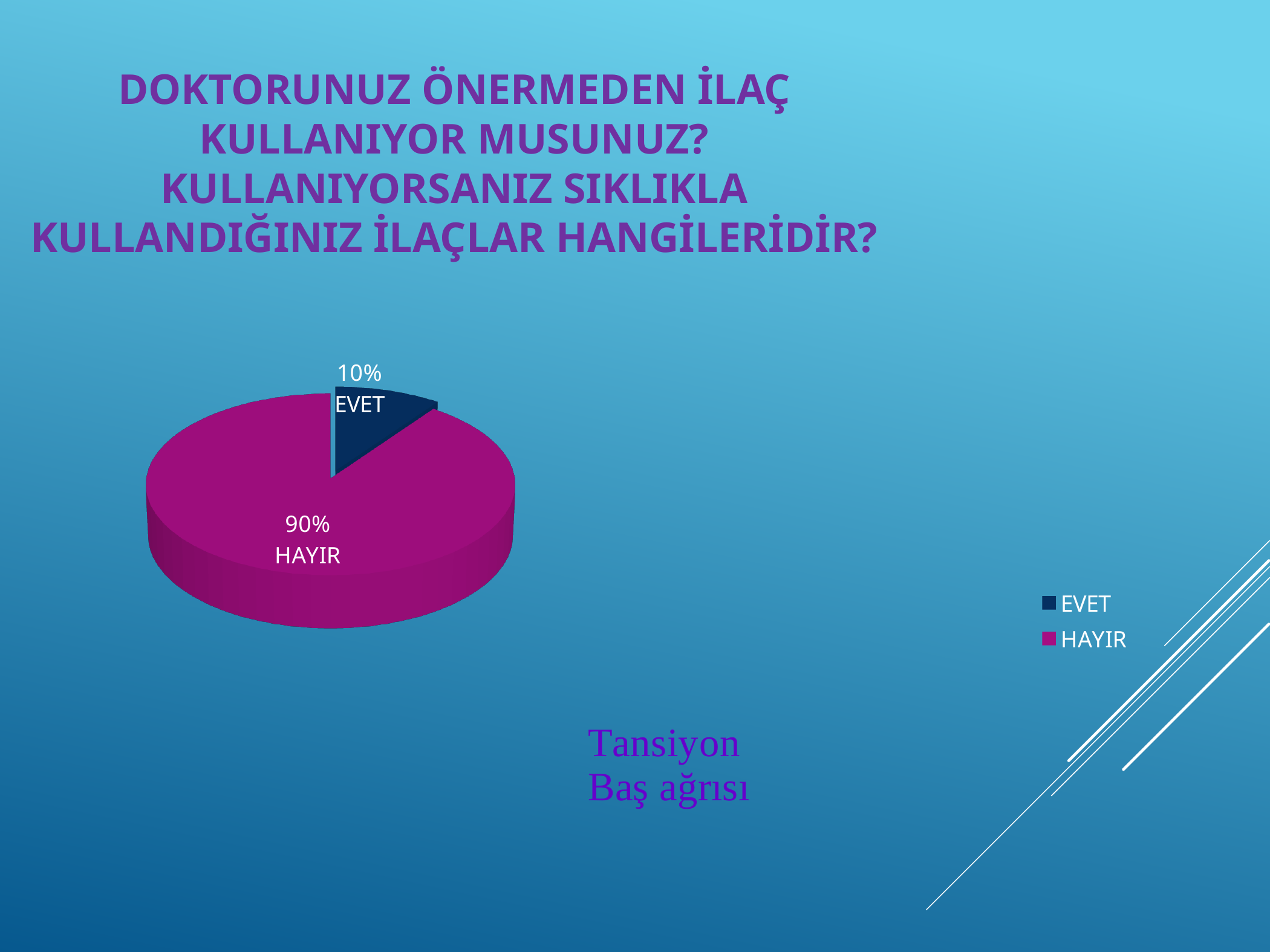
How many entries does the legend list? 2 Which slice of the pie is the smallest? EVET What colour is the HAYIR slice in the pie chart? magenta Which legend entry is shown in dark blue? EVET What is the difference in percentage points between the HAYIR slice and the EVET slice? 80 What kind of chart is shown on the slide? pie chart Which is larger, the EVET slice or the HAYIR slice? HAYIR What share of the pie does the EVET slice represent? 10% What percentage of the pie is labelled EVET? 10% How many slices does the pie chart have? 2 Which slice of the pie is the largest? HAYIR What percentage of the pie is labelled HAYIR? 90%